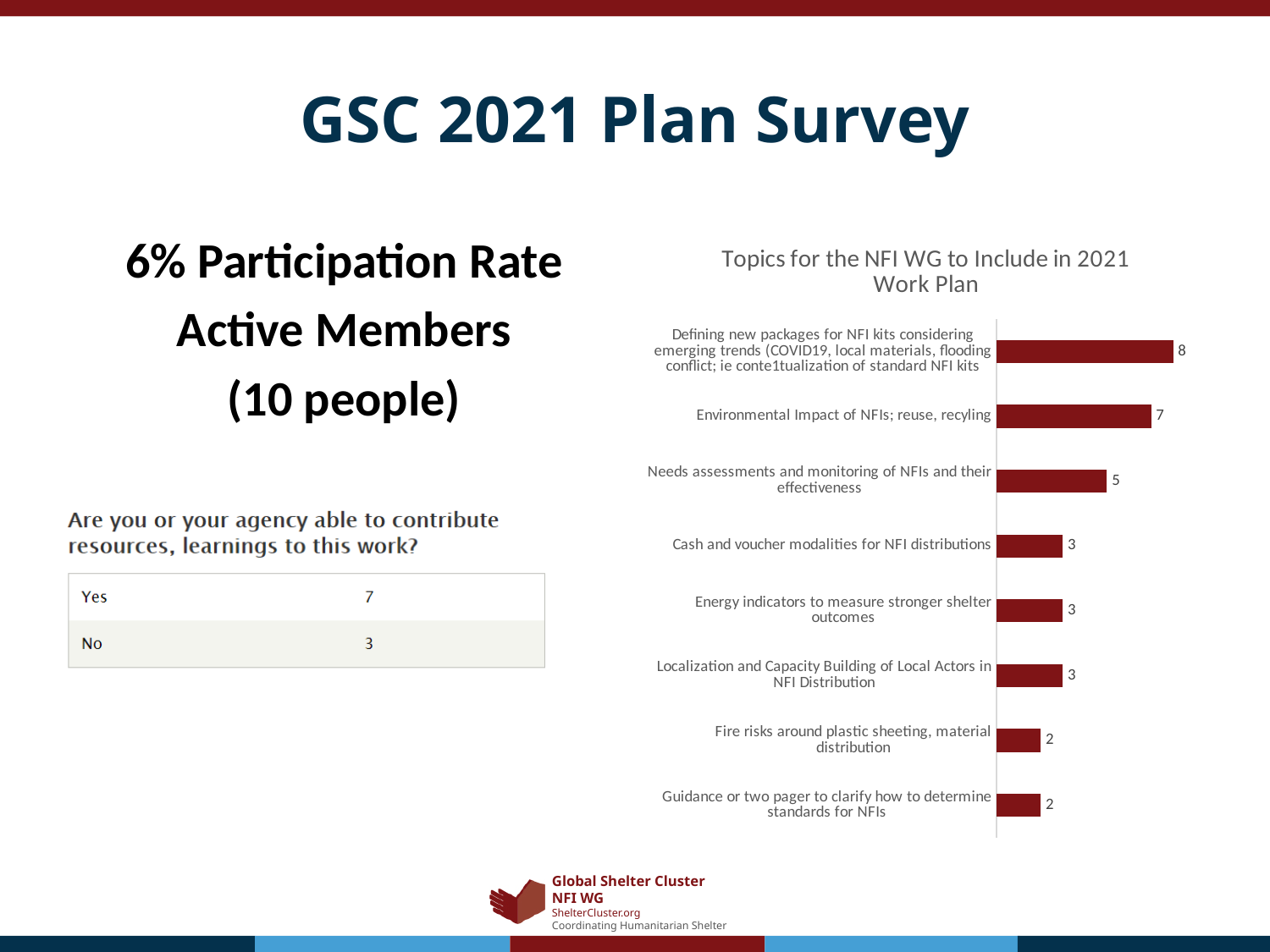
In the chart 'Topics for the NFI WG to Include in 2021 Work Plan', what is the value for 'Cash and voucher modalities for NFI distributions'? 3 In the chart 'Topics for the NFI WG to Include in 2021 Work Plan', which has the larger value: 'Needs assessments and monitoring of NFIs and their effectiveness' or 'Cash and voucher modalities for NFI distributions'? Needs assessments and monitoring of NFIs and their effectiveness In the chart 'Topics for the NFI WG to Include in 2021 Work Plan', which topic has the highest value? Defining new packages for NFI kits considering emerging trends (COVID19, local materials, flooding conflict; ie conte1tualization of standard NFI kits How many topics (bars) are shown in the chart 'Topics for the NFI WG to Include in 2021 Work Plan'? 8 In the chart 'Topics for the NFI WG to Include in 2021 Work Plan', what is the lowest value shown on any bar? 2 In the chart 'Topics for the NFI WG to Include in 2021 Work Plan', how much higher is 'Environmental Impact of NFIs; reuse, recyling' than 'Needs assessments and monitoring of NFIs and their effectiveness'? 2 What type of chart is 'Topics for the NFI WG to Include in 2021 Work Plan'? Bar chart What is the title of the chart on the right side of the slide? Topics for the NFI WG to Include in 2021 Work Plan In the chart 'Topics for the NFI WG to Include in 2021 Work Plan', what is the value for 'Fire risks around plastic sheeting, material distribution'? 2 In the chart 'Topics for the NFI WG to Include in 2021 Work Plan', what is the value for 'Environmental Impact of NFIs; reuse, recyling'? 7 In the chart 'Topics for the NFI WG to Include in 2021 Work Plan', what is the difference between the value for 'Defining new packages for NFI kits...' and 'Environmental Impact of NFIs; reuse, recyling'? 1 In the chart 'Topics for the NFI WG to Include in 2021 Work Plan', what is the value for 'Needs assessments and monitoring of NFIs and their effectiveness'? 5